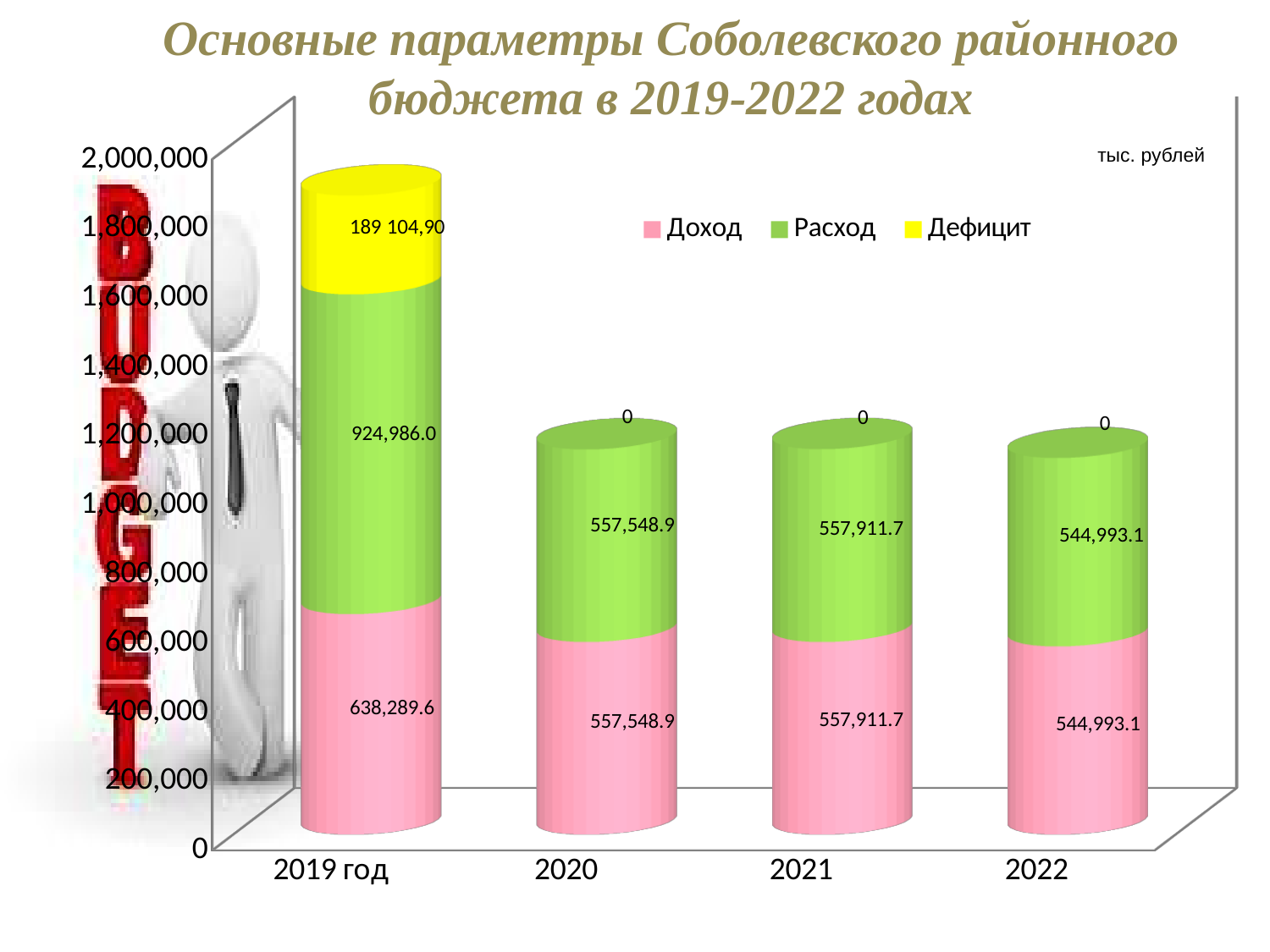
In which year is Расход the lowest? 2022 What is the value of Дефицит for 2019 год? 189 104,90 Which is larger, Доход in 2019 год or Доход in 2022? Доход in 2019 год What is the value of Дефицит for 2021? 0 What is the value of Расход for 2019 год? 924,986.0 What is the value of Доход for 2019 год? 638,289.6 How many years are shown on the x axis? 4 What is the difference between Расход and Доход in 2019 год? 286,696.4 How many series does the legend list? 3 What is the value of Доход for 2022? 544,993.1 What kind of chart is shown on the slide? Bar chart In which year is Доход the highest? 2019 год